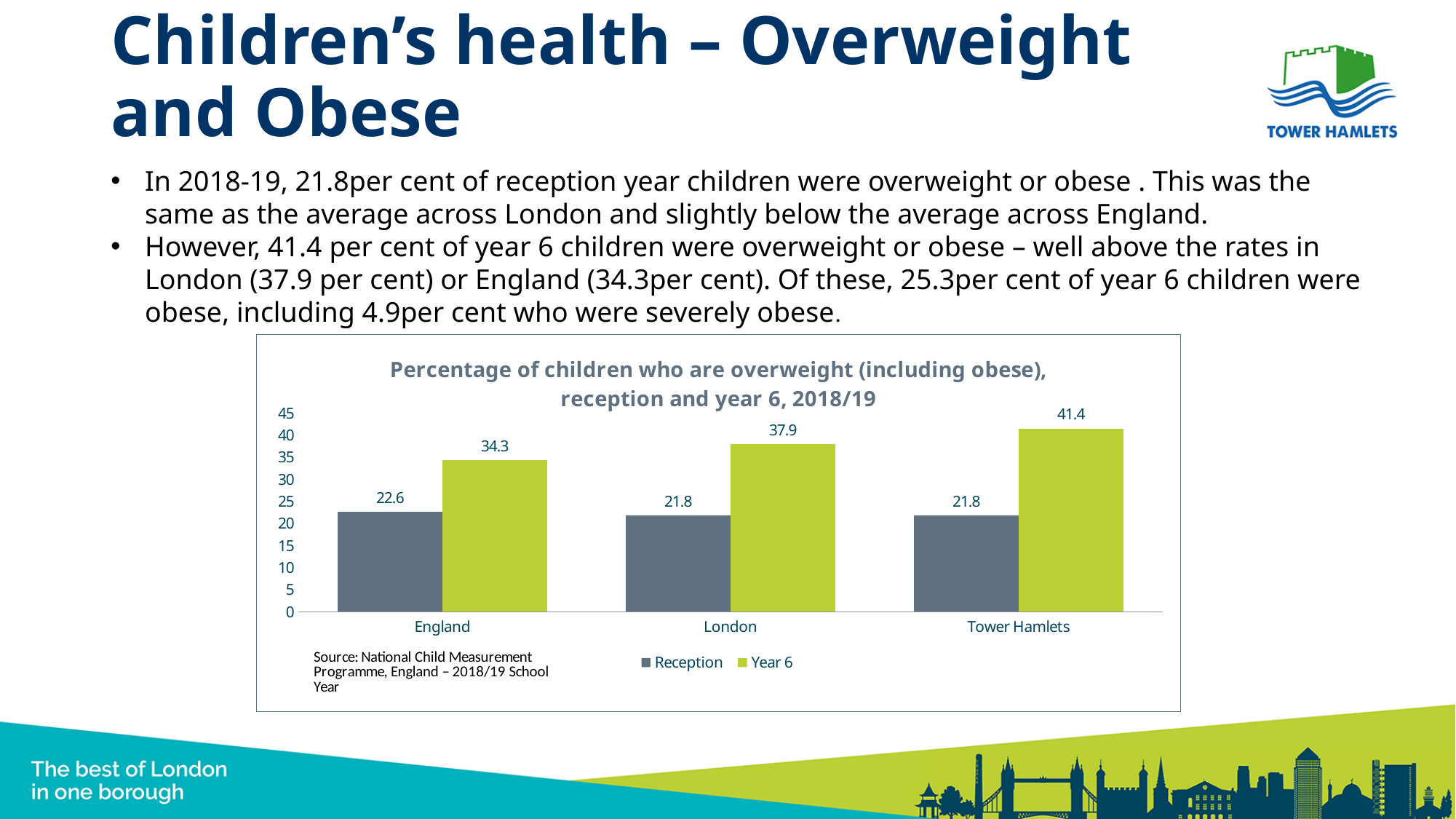
What is the Year 6 value for Tower Hamlets? 41.4 What is the Reception value for England? 22.6 Which area has the highest Year 6 value? Tower Hamlets Which area has the lowest Year 6 value? England What is the difference between the Year 6 and Reception values for Tower Hamlets? 19.6 Is the Year 6 value for Tower Hamlets greater or less than 40? greater What kind of chart is shown? Bar chart What is the Year 6 value for London? 37.9 What is the difference between the Year 6 values for Tower Hamlets and England? 7.1 How many areas are shown on the x axis? 3 Which is larger: the Reception value for England or the Reception value for London? England How many series does the legend list? 2